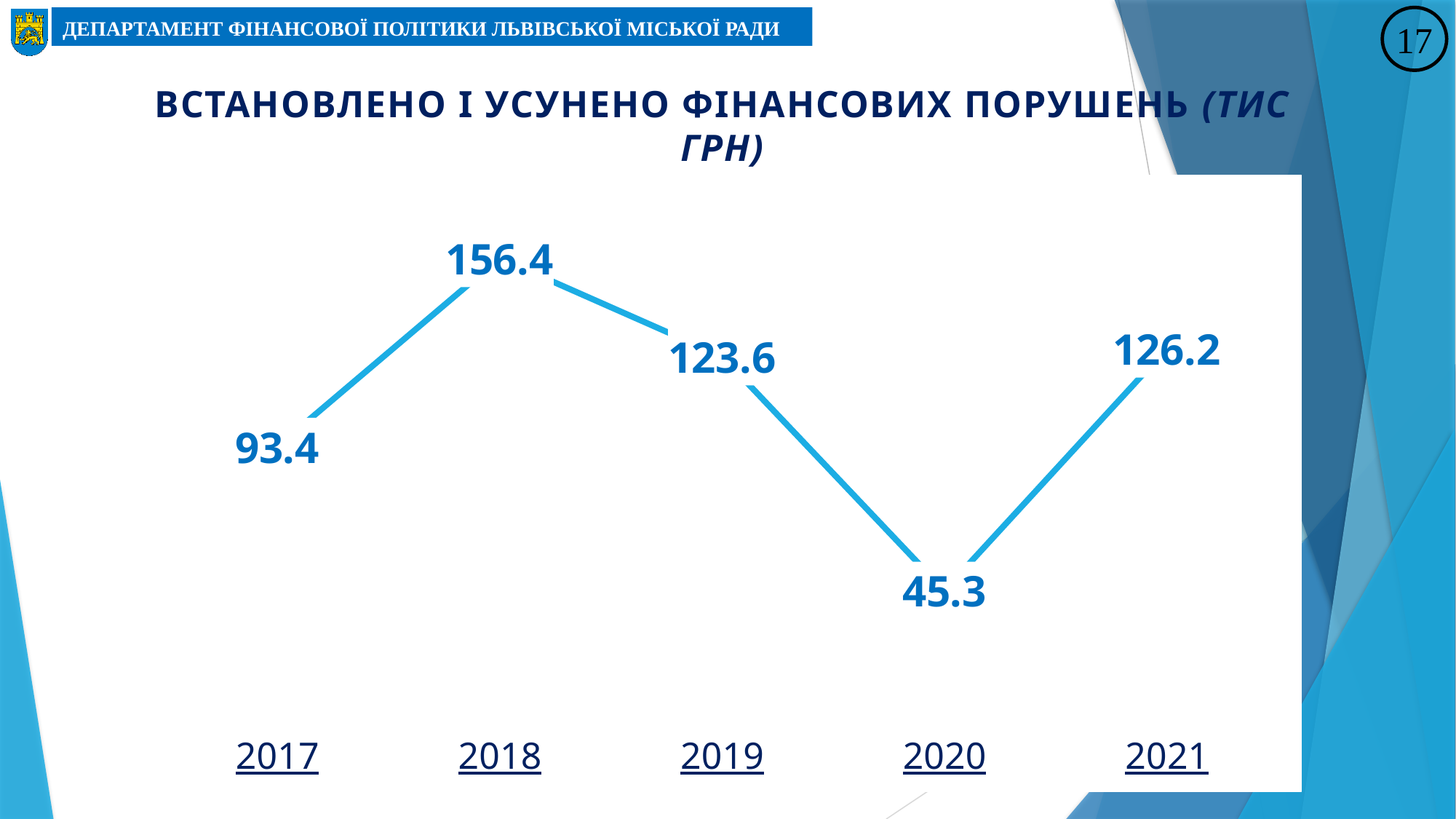
What is the value for 2021? 126.2 Does the value rise or fall from 2019 to 2020? fall Which year has the highest value? 2018 What is the value for 2017? 93.4 What is the value for 2020? 45.3 How many years are plotted on the chart? 5 What kind of chart is shown on the slide? line chart Which is larger, the value for 2019 or the value for 2021? 2021 What is the value for 2018? 156.4 What is the difference between the values for 2018 and 2019? 32.8 Which year has the lowest value? 2020 What is the difference between the values for 2021 and 2020? 80.9